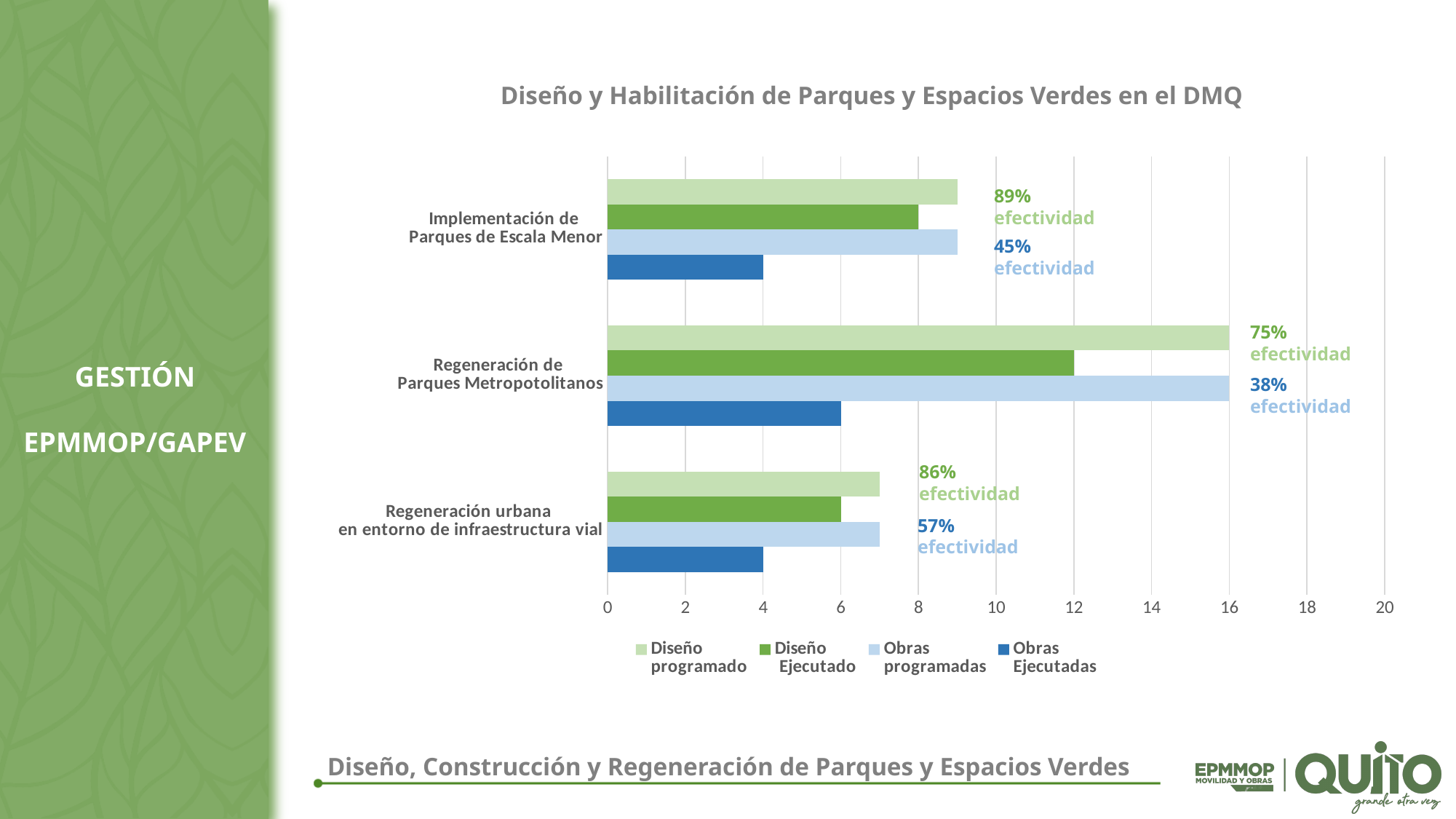
What efectividad percentage is shown in green for Implementación de Parques de Escala Menor? 89% Is the Diseño programado value for Implementación de Parques de Escala Menor greater or less than 10? less What efectividad percentage is shown in blue for Regeneración de Parques Metropolitanos? 38% How many series does the legend list? 4 How many categories are shown on the chart? 3 What is the value of Obras Ejecutadas for Regeneración urbana en entorno de infraestructura vial? 4 What is the difference between Diseño Ejecutado and Obras Ejecutadas for Regeneración de Parques Metropolitanos? 6 What is the value of Obras Ejecutadas for Regeneración de Parques Metropolitanos? 6 What kind of chart is shown on the slide? bar chart What is the value of Diseño Ejecutado for Implementación de Parques de Escala Menor? 8 What is the value of Diseño Ejecutado for Regeneración de Parques Metropolitanos? 12 Which category has the highest Diseño programado value? Regeneración de Parques Metropolitanos